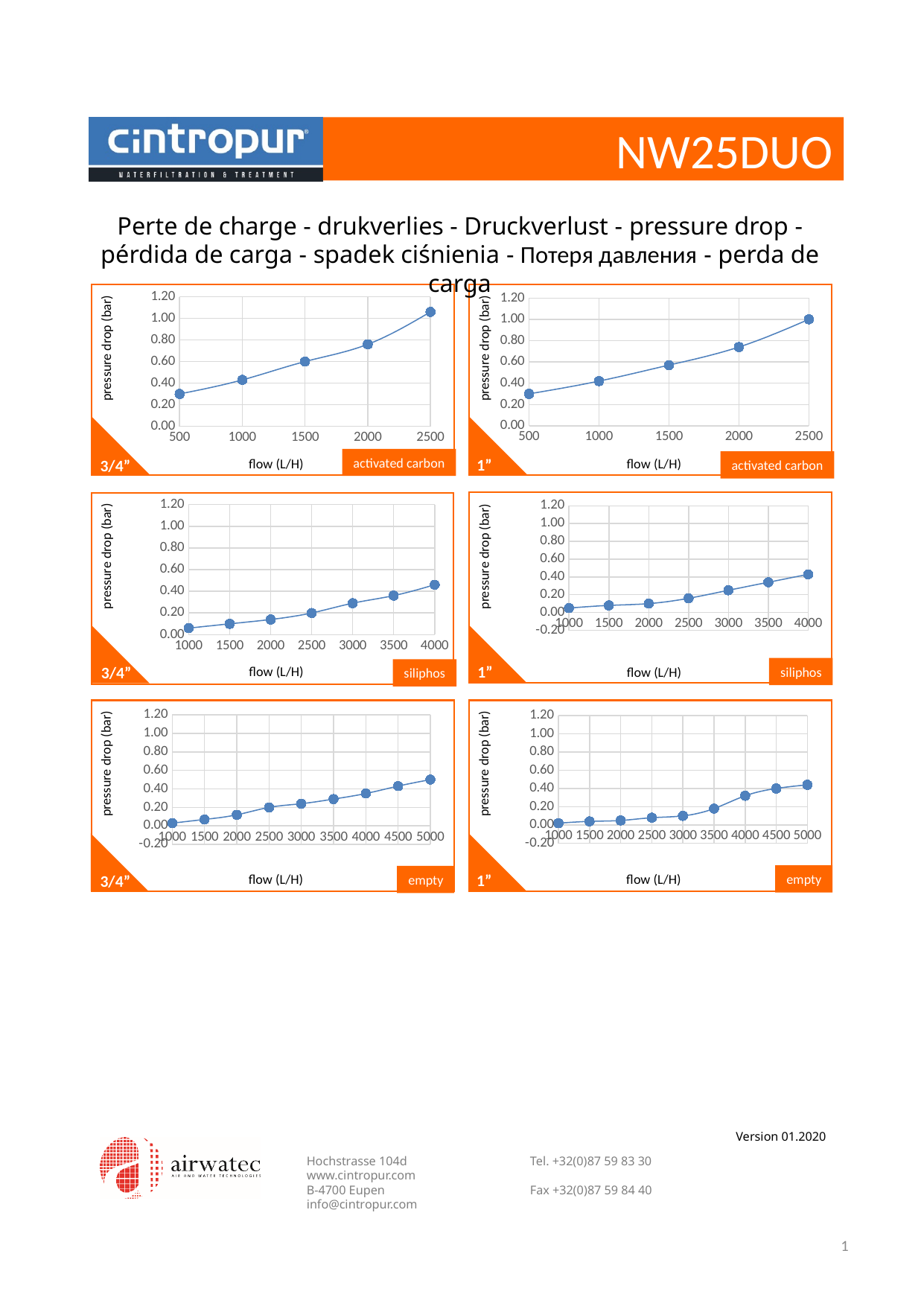
How many data points are plotted in the 3/4" activated carbon chart? 5 In the 1" activated carbon chart, is the pressure drop at 1500 L/H greater or less than 0.40? greater In the 3/4" siliphos chart, is the pressure drop at 4000 L/H greater or less than 0.60? less In the 3/4" empty chart, at which flow value is the pressure drop highest? 5000 How many data points are plotted in the 1" empty chart? 9 What kind of chart is the 3/4" activated carbon chart at the top left? line chart In the 1" empty chart, at which flow value is the pressure drop lowest? 1000 How many data points are plotted in the 3/4" siliphos chart? 7 In the 3/4" activated carbon chart, is the pressure drop at 500 L/H greater or less than 0.40? less What is the y-axis label on the 1" siliphos chart? pressure drop (bar) In the 1" activated carbon chart, does the pressure drop rise or fall as flow increases? rises